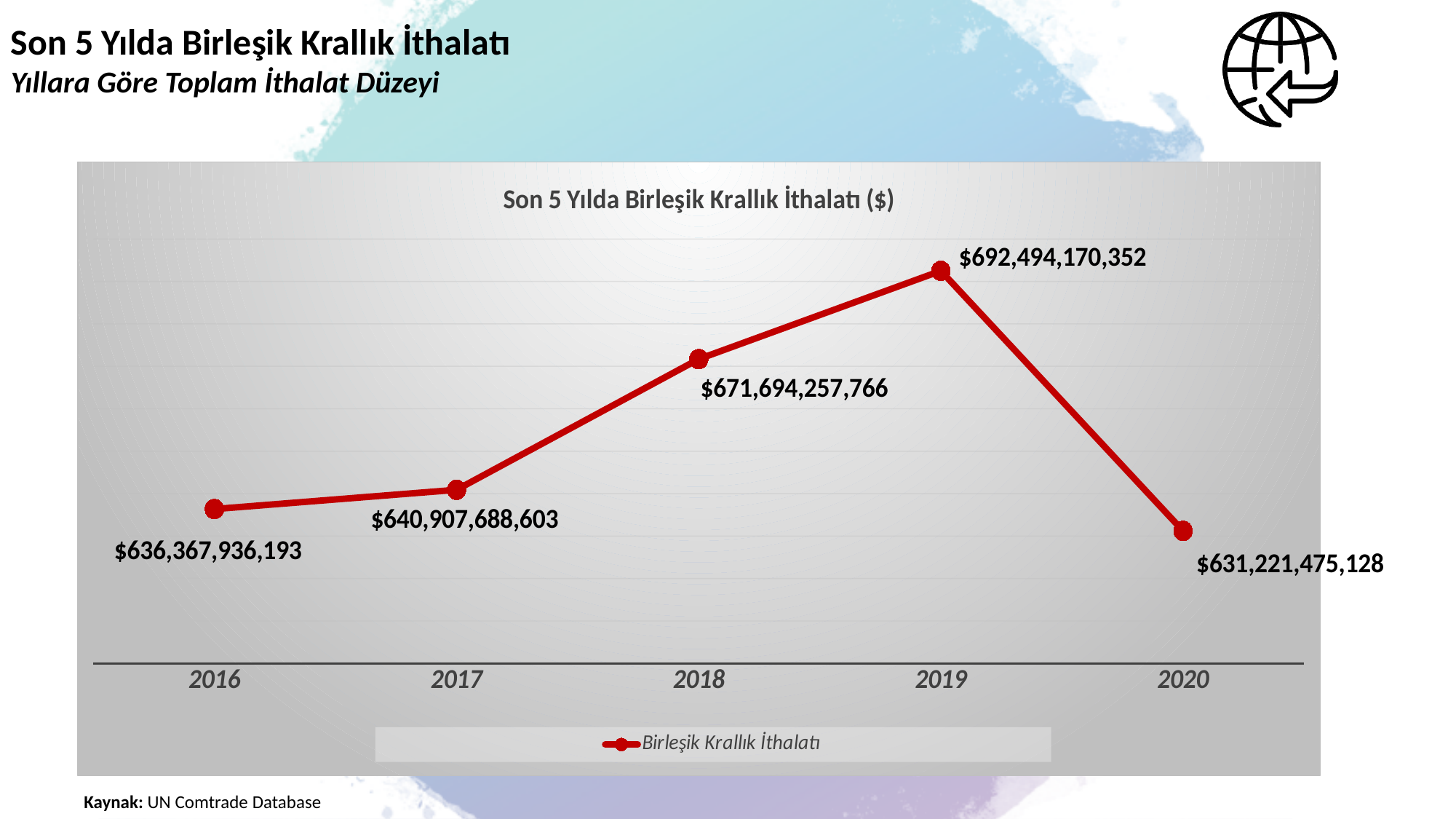
What kind of chart is shown? Line chart What is the value for 2020? $631,221,475,128 Which year has the lowest import value? 2020 What is the difference between the 2019 and 2018 values? $20,799,912,586 How many years are plotted on the chart? 5 By how much did the value fall from 2019 to 2020? $61,272,695,224 How many series does the legend list? 1 Which is larger, the value for 2017 or the value for 2020? 2017 Which year has the highest import value? 2019 What is the value for 2018? $671,694,257,766 What is the value for 2016? $636,367,936,193 What is the title of the chart? Son 5 Yılda Birleşik Krallık İthalatı ($)